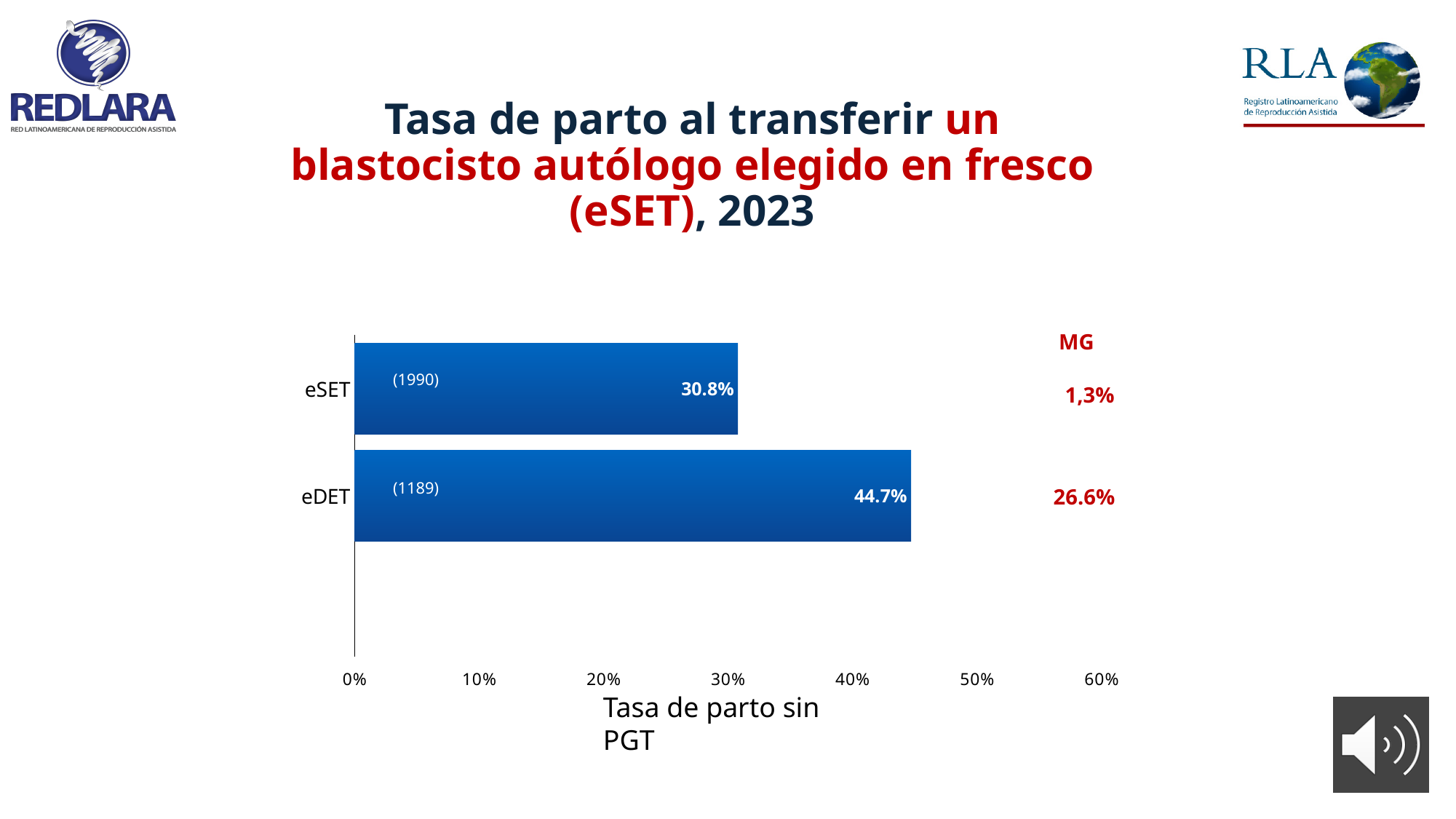
Which category has the highest value? eDET What is the value for eSET? 30.8% What is the MG value shown next to the eDET bar? 26.6% What is the number shown in parentheses on the eSET bar? (1990) Which is larger, the value for eSET or the value for eDET? eDET Is the value for eSET greater or less than 40%? less What is the difference between the values for eDET and eSET? 13.9% Which category has the lowest value? eSET Is the value for eDET greater or less than 40%? greater How many categories are shown in the chart? 2 What kind of chart is shown on the slide? bar chart What is the value for eDET? 44.7%